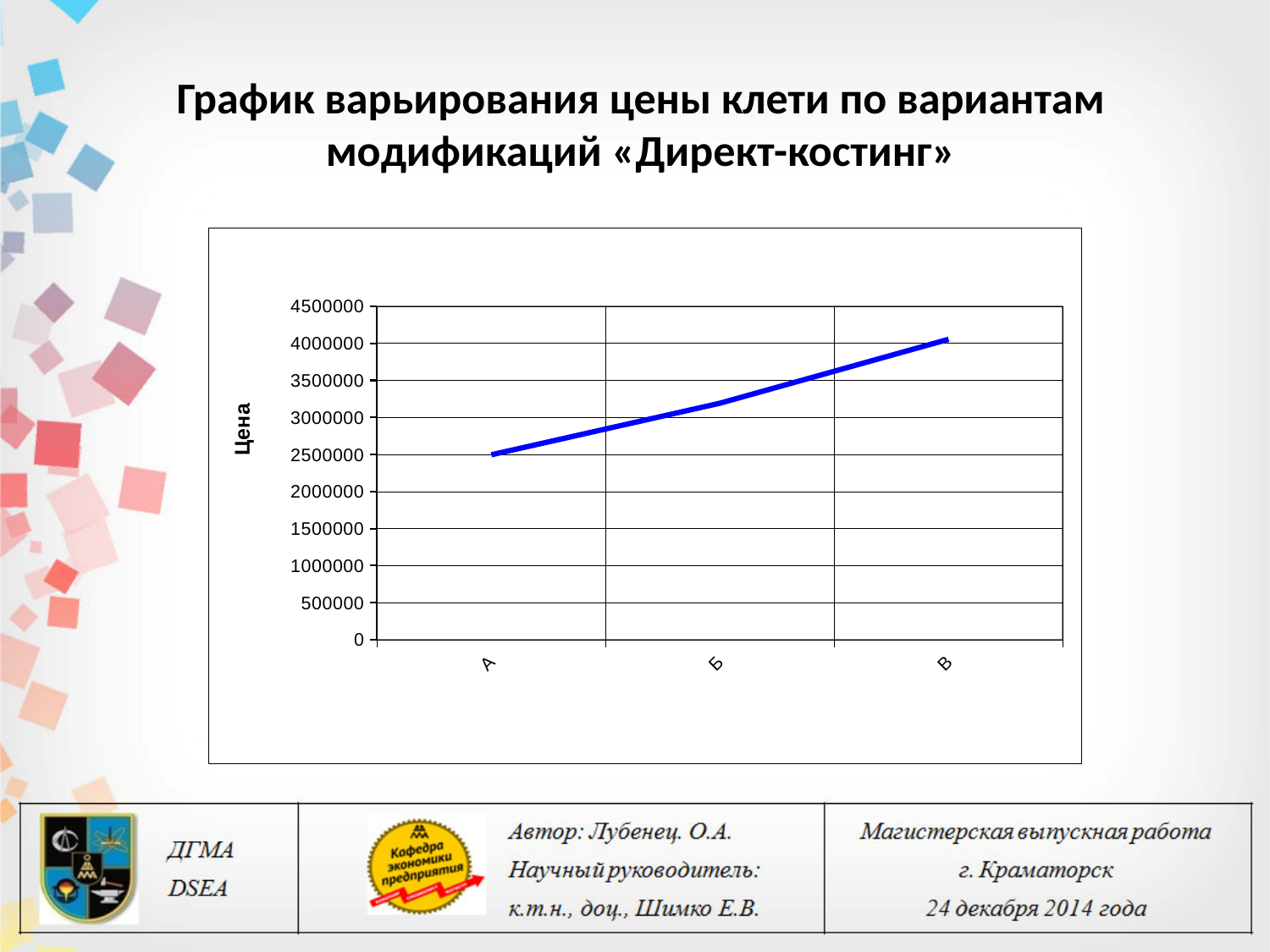
Is the value for В greater or less than 3500000? greater How many categories are plotted along the x axis? 3 Is the value for А greater or less than 3000000? less Is the value for Б greater or less than 3000000? greater Which category has the highest value? В What colour is the plotted line? blue What kind of chart is shown on the slide? line chart Do the values rise or fall from А to В along the x axis? rise Which category has the lowest value? А Which has the larger value, Б or В? В What is the label of the vertical axis? Цена